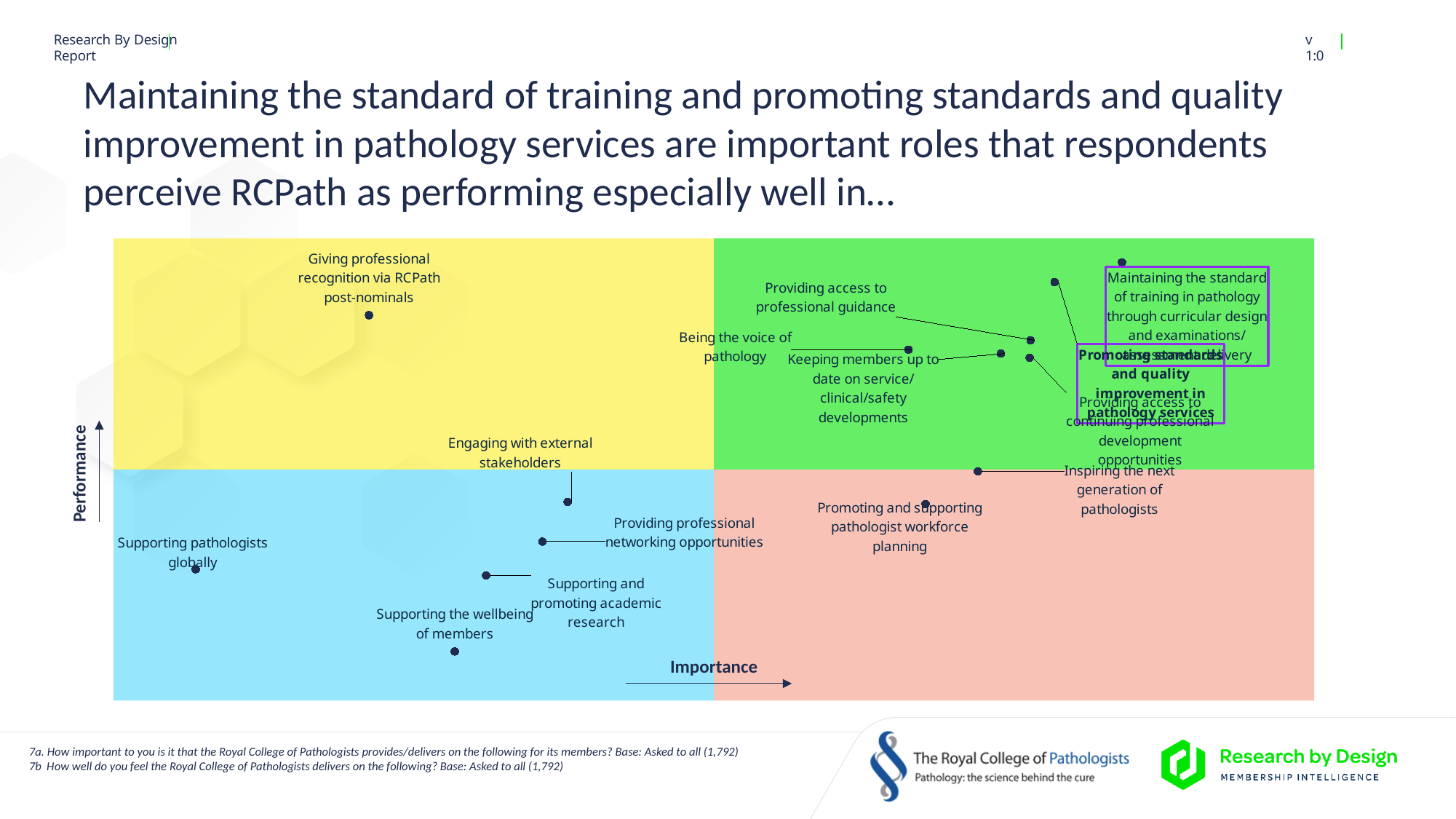
What is the label of the vertical axis of the chart? Performance Which is rated higher on Importance: Supporting the wellbeing of members or Supporting pathologists globally? Supporting the wellbeing of members How many items are plotted in the blue bottom-left quadrant? 5 Which item is plotted lowest on the Performance axis? Supporting the wellbeing of members How many data points are plotted on the chart? 14 Which item is plotted highest on the Performance axis? Maintaining the standard of training in pathology through curricular design and examinations/assessment delivery In which coloured quadrant does the point for Giving professional recognition via RCPath post-nominals fall? Yellow (top-left) What is the label of the horizontal axis of the chart? Importance What kind of chart is shown on the slide? Scatter plot Which is rated higher on Performance: Giving professional recognition via RCPath post-nominals or Engaging with external stakeholders? Giving professional recognition via RCPath post-nominals Which item is plotted furthest to the right on the Importance axis? Maintaining the standard of training in pathology through curricular design and examinations/assessment delivery Which item is plotted lowest on the Importance axis? Supporting pathologists globally